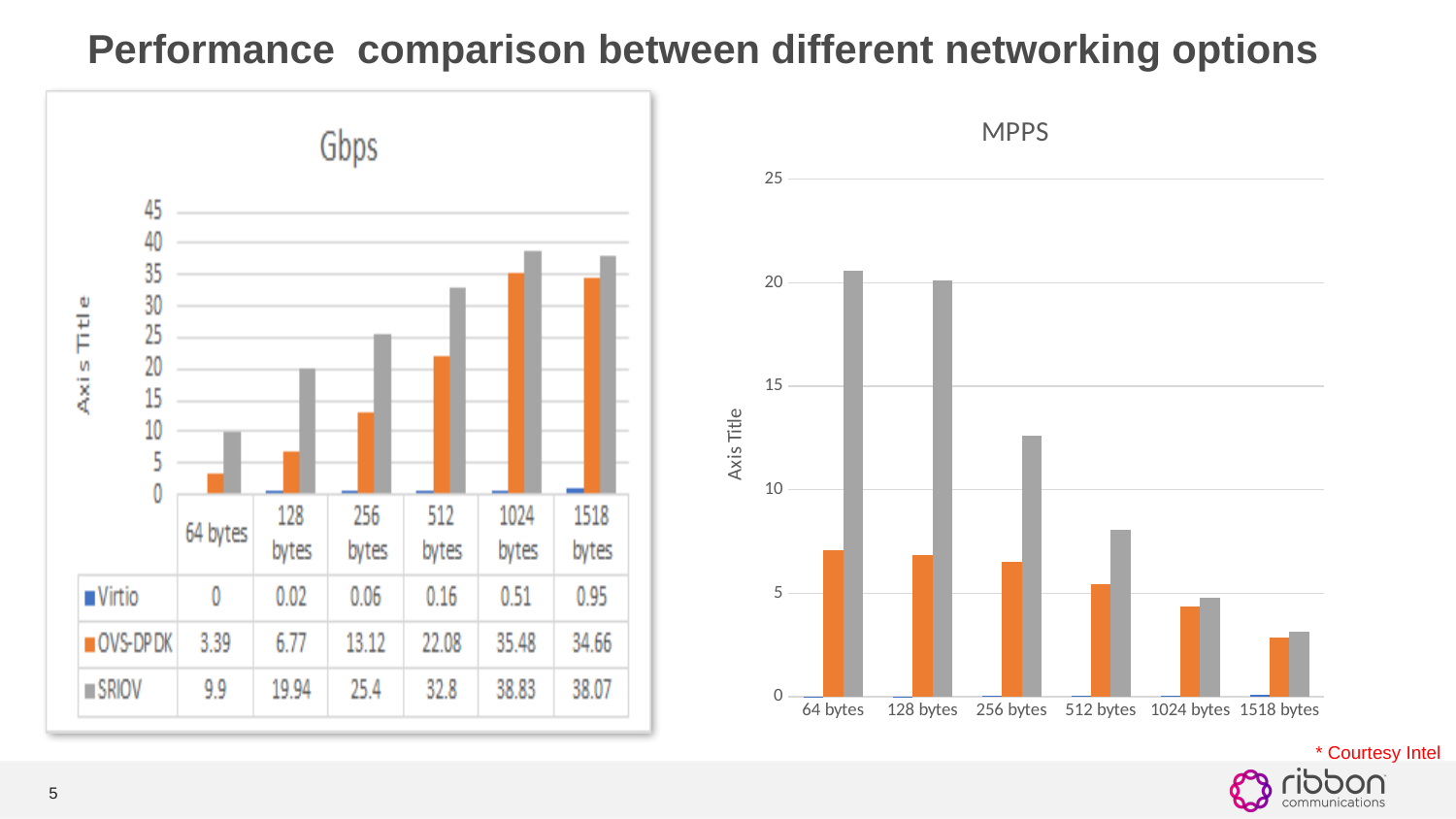
How many series does the legend of the Gbps chart list? 3 How many packet-size categories are shown on the x axis of the MPPS chart? 6 What kind of chart is the MPPS chart? bar chart In the MPPS chart, do the gray bars rise or fall as packet size increases along the x axis? fall In the Gbps chart, what is the difference between the SRIOV and OVS-DPDK values for 64 bytes? 6.51 In the Gbps chart, what is the OVS-DPDK value for 256 bytes? 13.12 In the Gbps chart, which packet size has the highest SRIOV value? 1024 bytes In the MPPS chart, is the gray bar for 256 bytes greater or less than 10? greater In the Gbps chart, which packet size has the lowest OVS-DPDK value? 64 bytes In the Gbps chart, what is the Virtio value for 1518 bytes? 0.95 In the Gbps chart, which is larger for 512 bytes: OVS-DPDK or SRIOV? SRIOV In the Gbps chart, what is the SRIOV value for 1024 bytes? 38.83